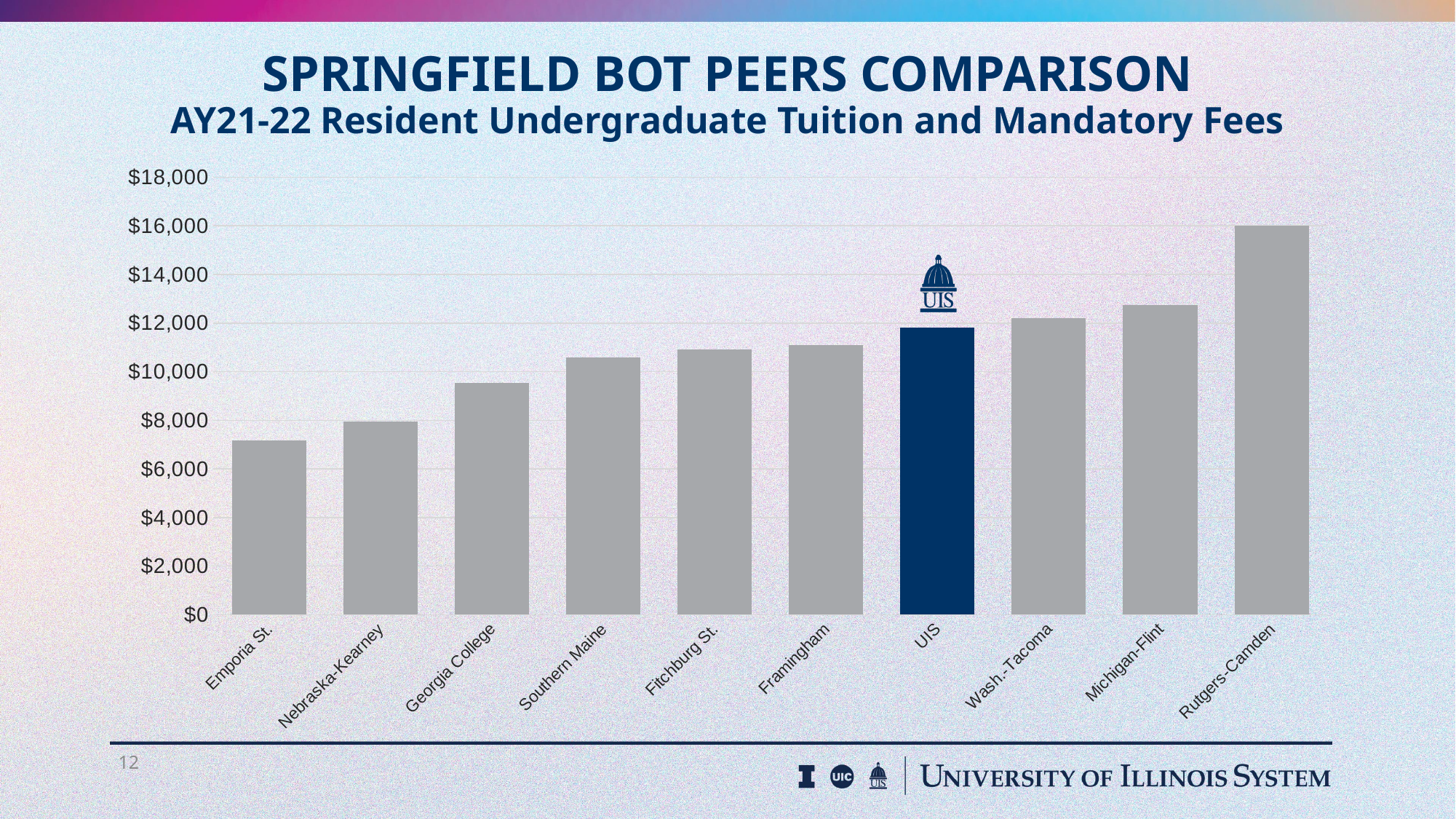
Do the values rise or fall moving from left to right along the x axis? Rise Which institution has the highest resident undergraduate tuition and mandatory fees? Rutgers-Camden Which institution's bar is highlighted in dark blue? UIS How many institutions are shown on the chart? 10 Is the value for Michigan-Flint greater or less than $12,000? greater What kind of chart is shown on the slide? Bar chart Is the value for Emporia St. greater or less than $8,000? less Is the value for Southern Maine greater or less than $10,000? greater Which institution has the lowest resident undergraduate tuition and mandatory fees? Emporia St. Which is larger, the value for UIS or the value for Rutgers-Camden? Rutgers-Camden